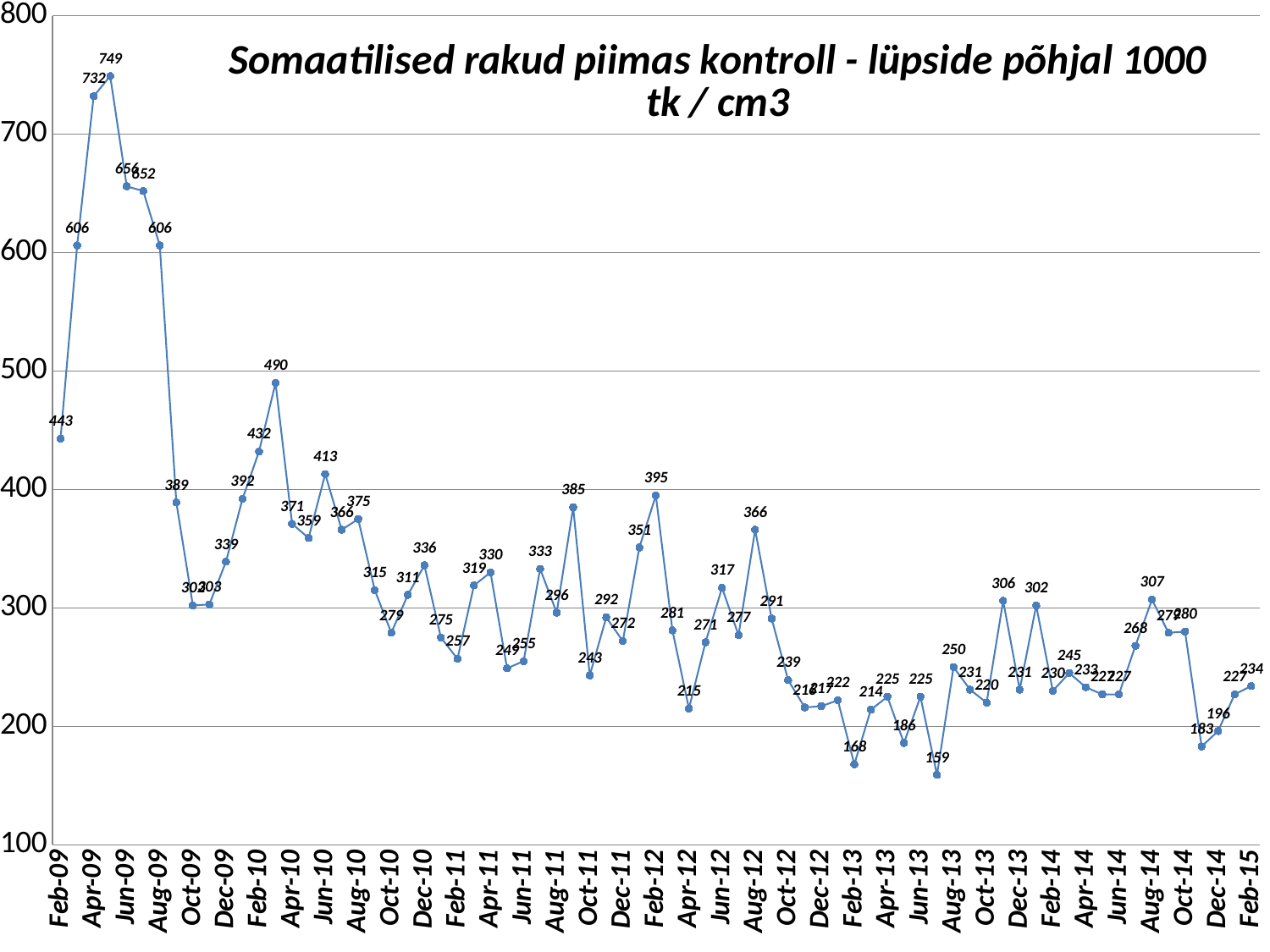
What is the value for Feb-13? 168 What is the highest value plotted on the chart? 749 Which is larger, the value for Feb-12 or the value for Aug-12? Feb-12 What is the value for Feb-15? 234 What is the value for Aug-12? 366 What is the value for Feb-12? 395 What is the value for Feb-09? 443 What is the difference between the value for Feb-09 and the value for Feb-15? 209 What is the lowest value plotted on the chart? 159 What kind of chart is shown on the slide? line chart Do the values generally rise or fall from Feb-09 to Feb-15? fall What is the title of the chart? Somaatilised rakud piimas kontroll - lüpside põhjal 1000 tk / cm3